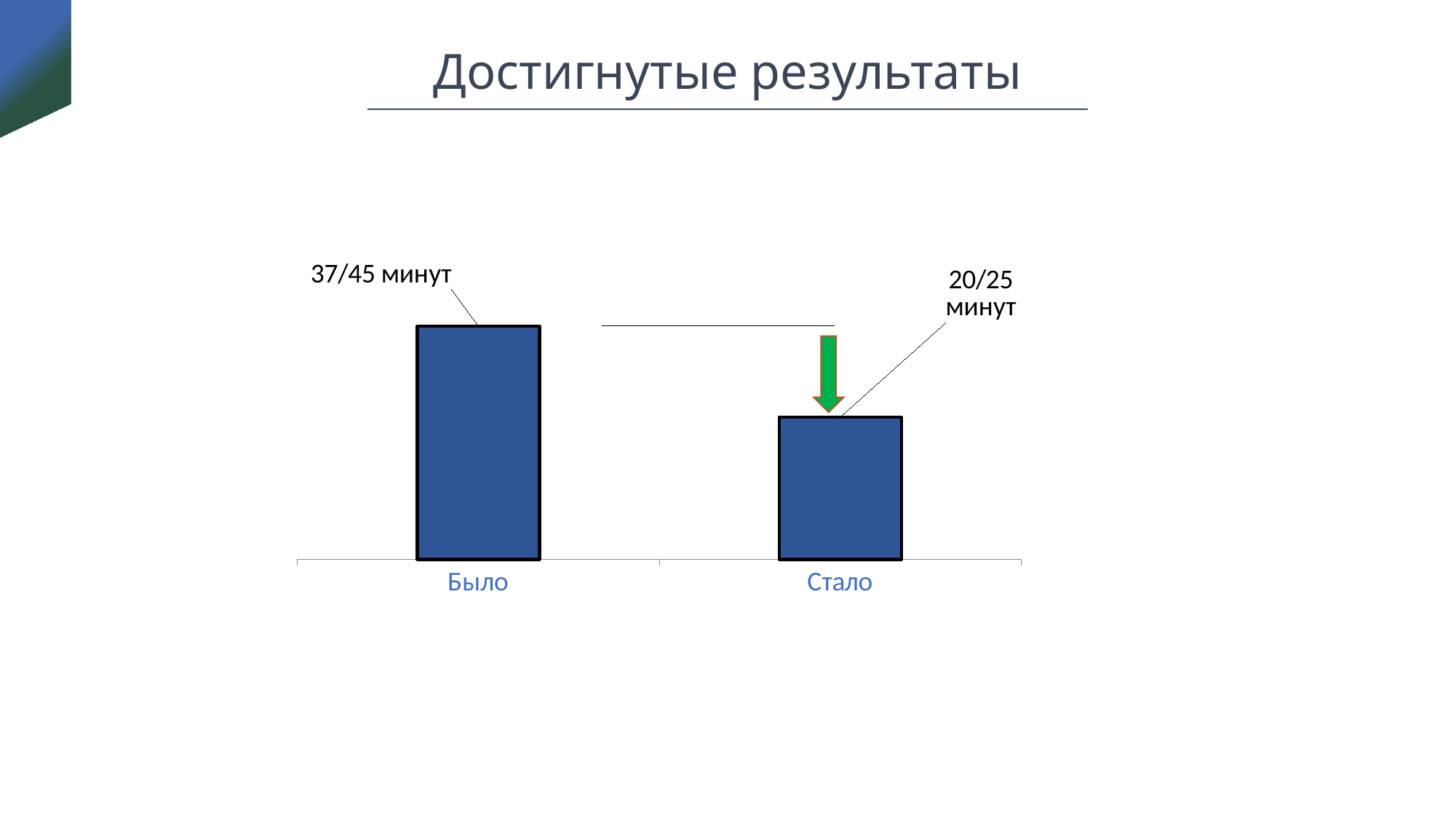
What are the two category labels on the x axis of the chart? Было, Стало How many bars are plotted in the chart? 2 What type of chart is shown on the slide? bar chart Which category has the shorter bar? Стало What label is shown for the "Было" bar? 37/45 минут What is the title of the slide containing the chart? Достигнутые результаты Which category has the taller bar? Было Do the bar values rise or fall from "Было" to "Стало"? fall Is the bar for "Было" taller or shorter than the bar for "Стало"? taller What label is shown for the "Стало" bar? 20/25 минут